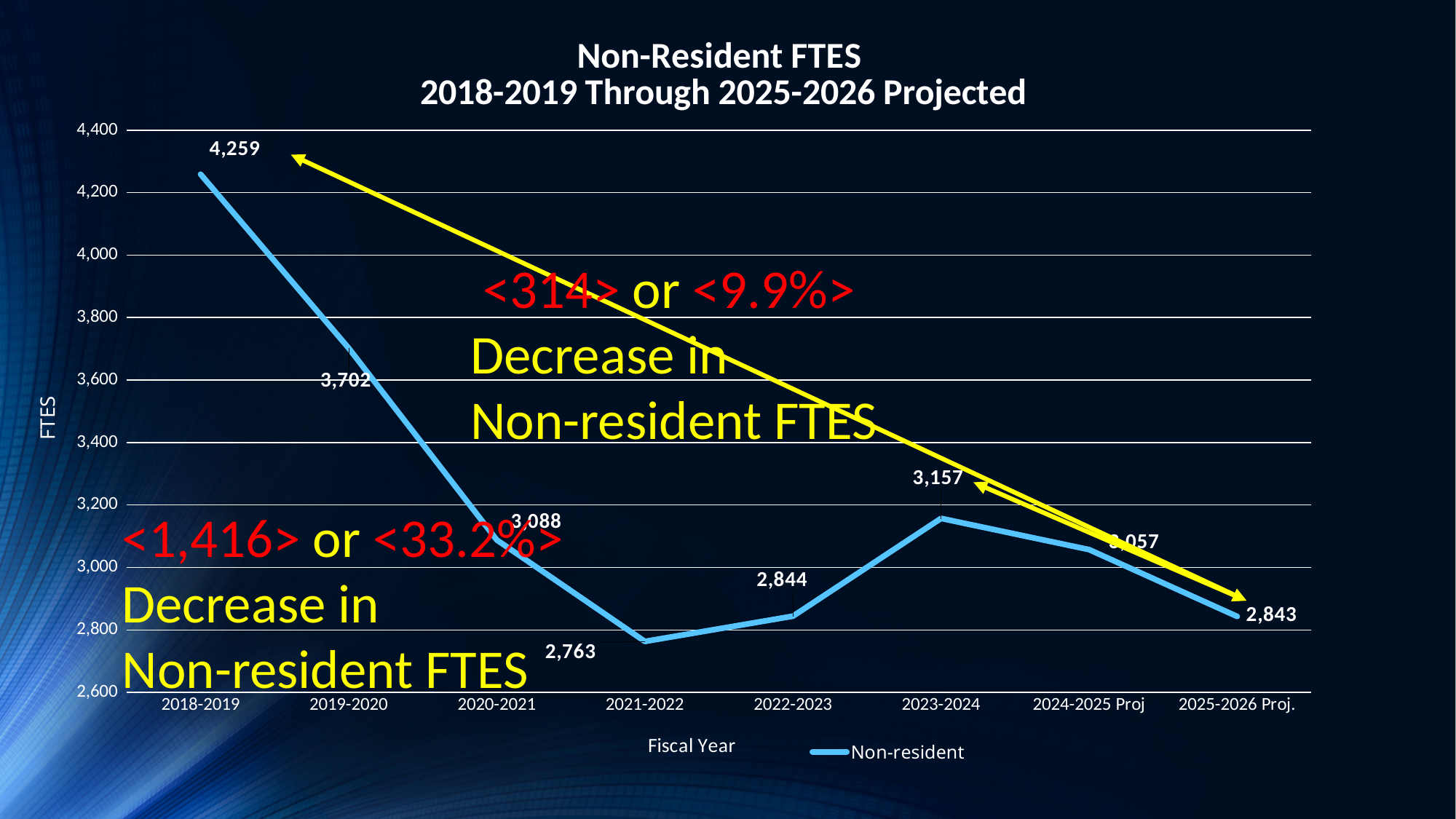
What is the Non-resident FTES value for 2018-2019? 4,259 What kind of chart is shown on the slide? line chart Is the Non-resident FTES value for 2019-2020 greater or less than 3,600? greater What is the Non-resident FTES value for 2021-2022? 2,763 Do the Non-resident FTES values rise or fall from 2018-2019 to 2021-2022? fall What is the difference between the Non-resident FTES values for 2018-2019 and 2025-2026 Proj.? 1,416 How many fiscal years are plotted on the x axis? 8 Which fiscal year has the highest Non-resident FTES value? 2018-2019 How many series does the legend list? 1 Which fiscal year has the lowest Non-resident FTES value? 2021-2022 Which is larger, the Non-resident FTES value for 2022-2023 or for 2023-2024? 2023-2024 What is the Non-resident FTES value for 2023-2024? 3,157